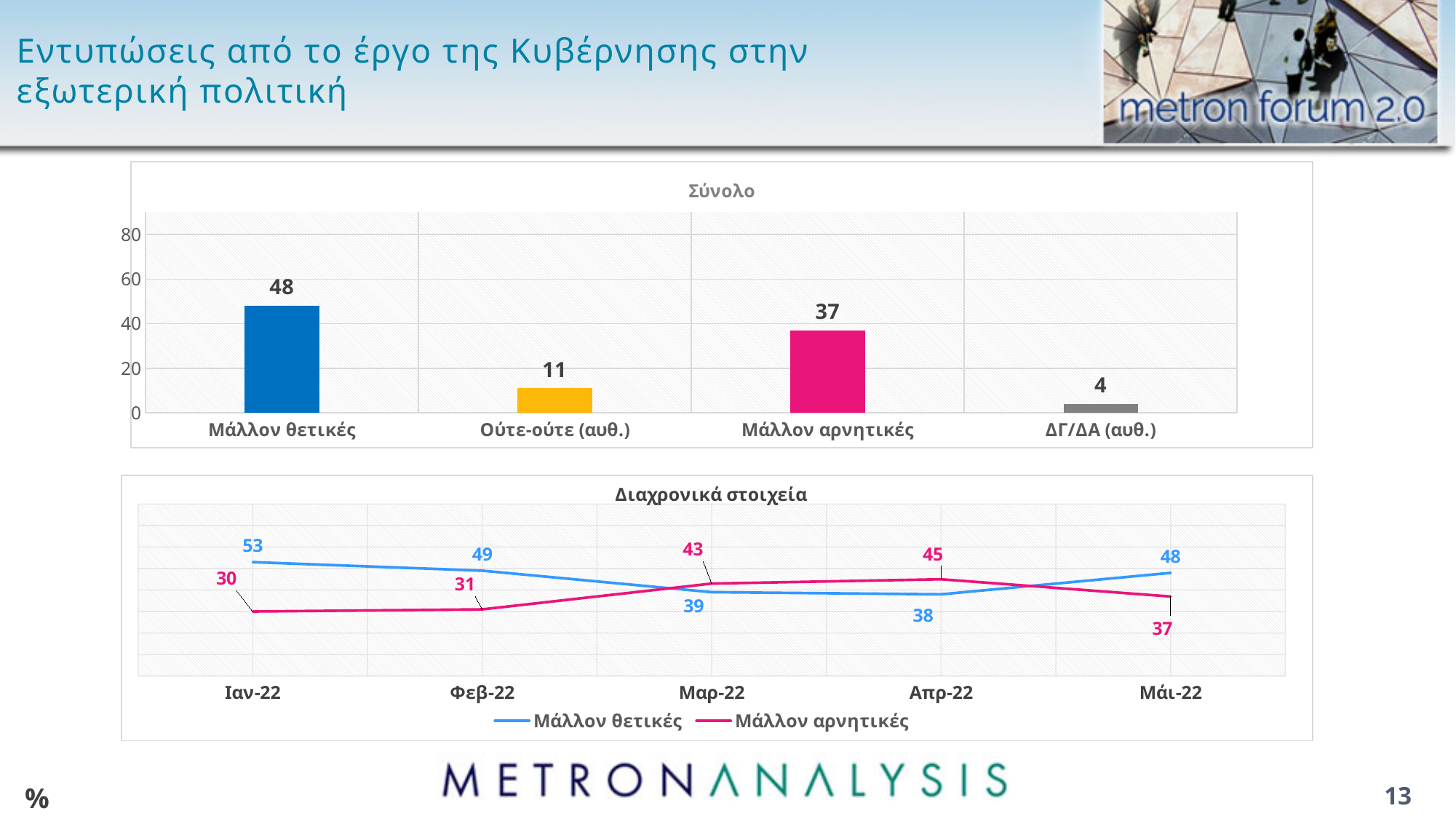
In the 'Σύνολο' chart, what is the value for 'Μάλλον θετικές'? 48 In the 'Σύνολο' chart, which category has the lowest value? ΔΓ/ΔΑ (αυθ.) What kind of chart is the 'Σύνολο' chart? bar chart In the 'Διαχρονικά στοιχεία' chart, which is larger in Απρ-22: 'Μάλλον θετικές' or 'Μάλλον αρνητικές'? Μάλλον αρνητικές What kind of chart is the 'Διαχρονικά στοιχεία' chart? line chart In the 'Διαχρονικά στοιχεία' chart, in which month is 'Μάλλον θετικές' highest? Ιαν-22 In the 'Διαχρονικά στοιχεία' chart, how many series does the legend list? 2 In the 'Διαχρονικά στοιχεία' chart, what is the value for 'Μάλλον αρνητικές' in Μαρ-22? 43 In the 'Διαχρονικά στοιχεία' chart, does 'Μάλλον θετικές' rise or fall from Ιαν-22 to Απρ-22? fall In the 'Σύνολο' chart, what is the difference between 'Μάλλον θετικές' and 'Μάλλον αρνητικές'? 11 In the 'Διαχρονικά στοιχεία' chart, what is the difference between 'Μάλλον θετικές' and 'Μάλλον αρνητικές' in Ιαν-22? 23 In the 'Σύνολο' chart, how many categories are shown? 4